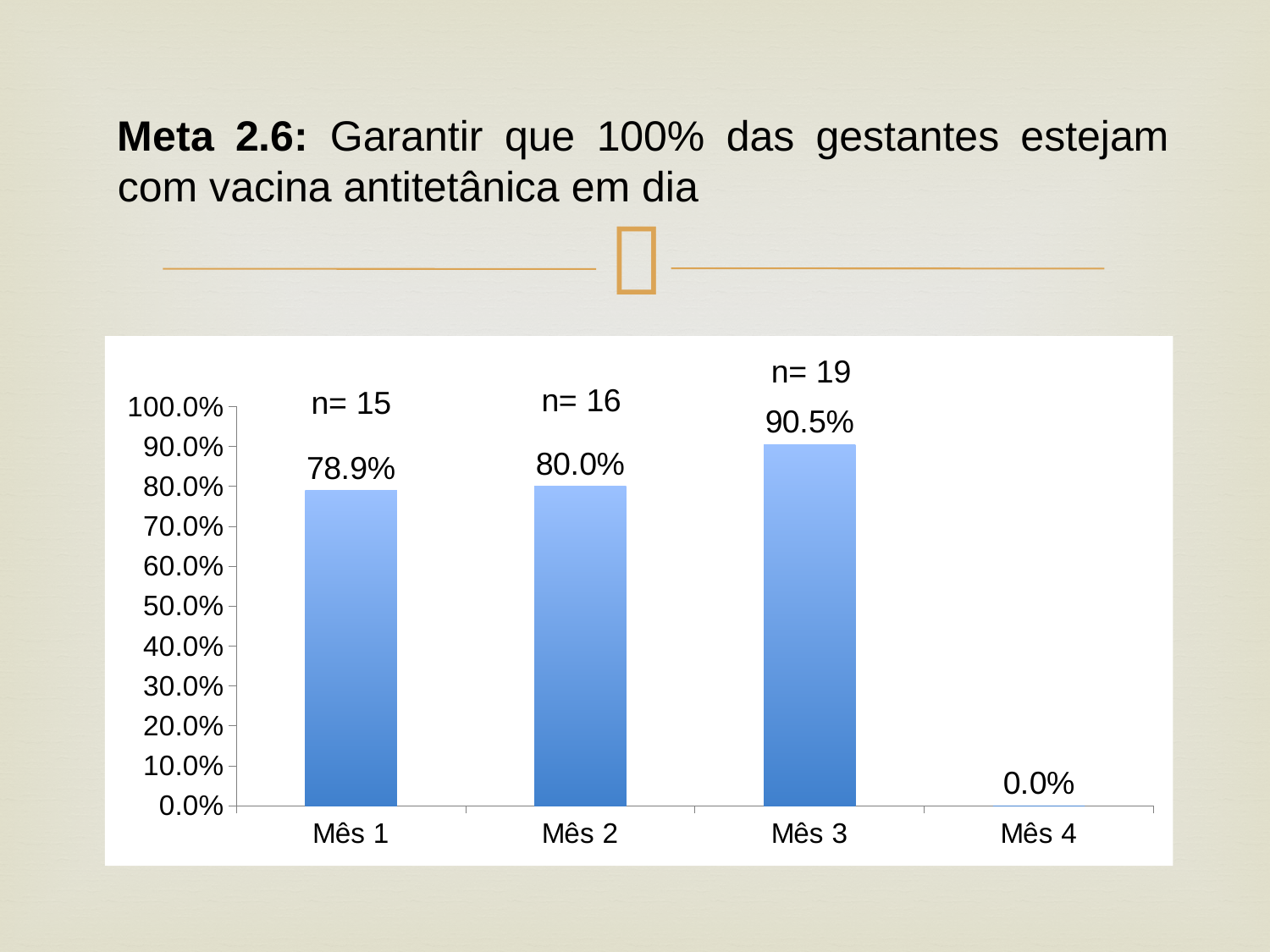
What is the n value annotated above the bar for Mês 3? n= 19 Which month has the lowest value? Mês 4 Is the value for Mês 1 greater or less than 70.0%? greater What is the value for Mês 2? 80.0% Which month has the highest value? Mês 3 What kind of chart is shown on the slide? bar chart What is the value for Mês 1? 78.9% What is the value for Mês 3? 90.5% How many categories are shown on the x axis? 4 What is the value for Mês 4? 0.0% What is the difference between the values for Mês 3 and Mês 1? 11.6% Which is larger, the value for Mês 2 or the value for Mês 3? Mês 3